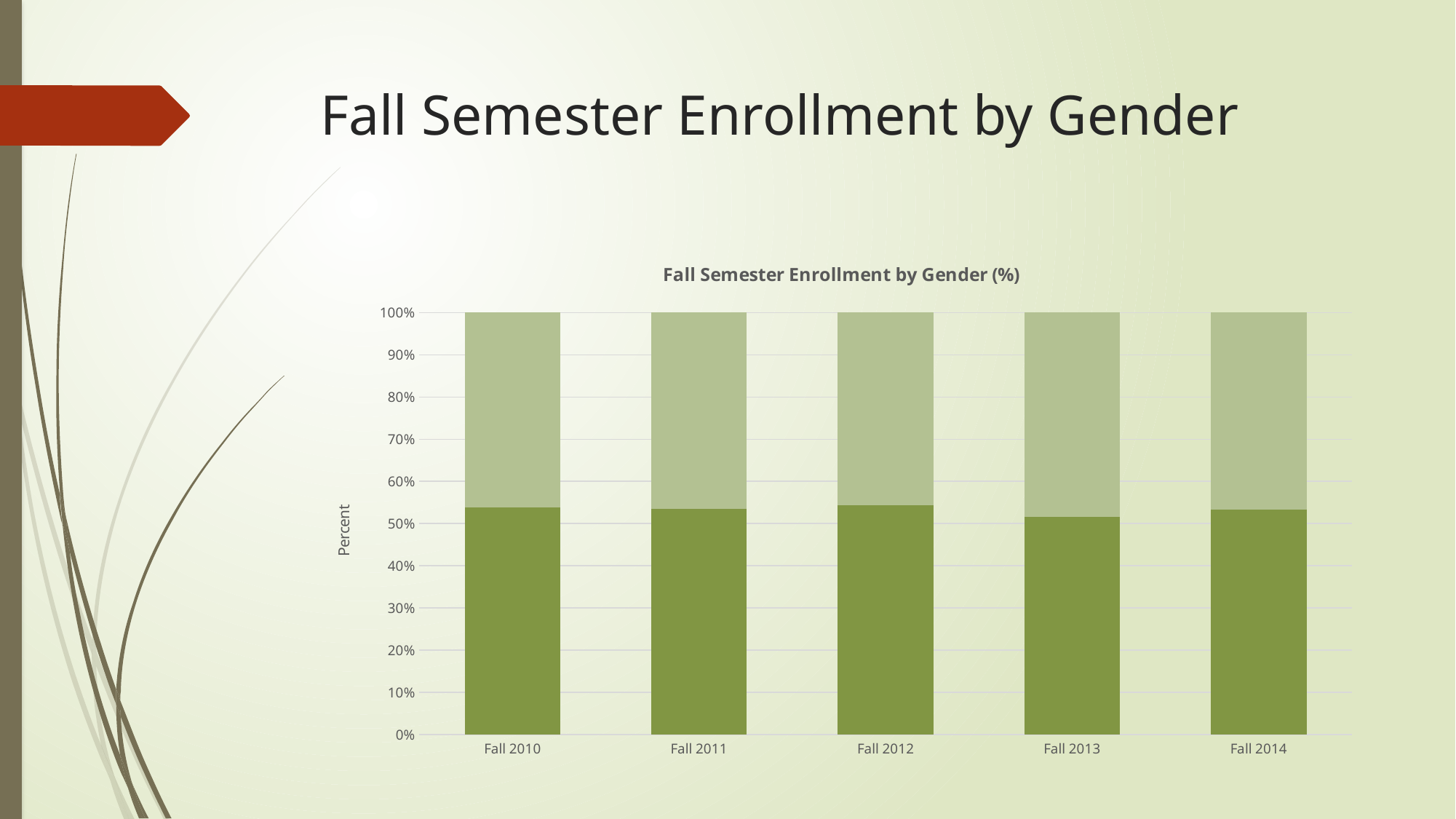
What is the total height of the stacked bar for Fall 2010? 100% What is the title of the chart? Fall Semester Enrollment by Gender (%) Is the dark green (bottom) segment for Fall 2013 greater or less than 60%? less Is the dark green (bottom) segment for Fall 2010 greater or less than 50%? greater Is the light green (top) segment for Fall 2012 greater or less than 50%? less Which has the larger dark green (bottom) segment, Fall 2012 or Fall 2013? Fall 2012 In which fall semester is the dark green (bottom) segment the smallest? Fall 2013 What is the label on the vertical axis of the chart? Percent Which has the larger light green (top) segment, Fall 2013 or Fall 2012? Fall 2013 How many fall semesters are shown on the x axis of the chart? 5 What kind of chart is shown on the slide? Stacked bar chart